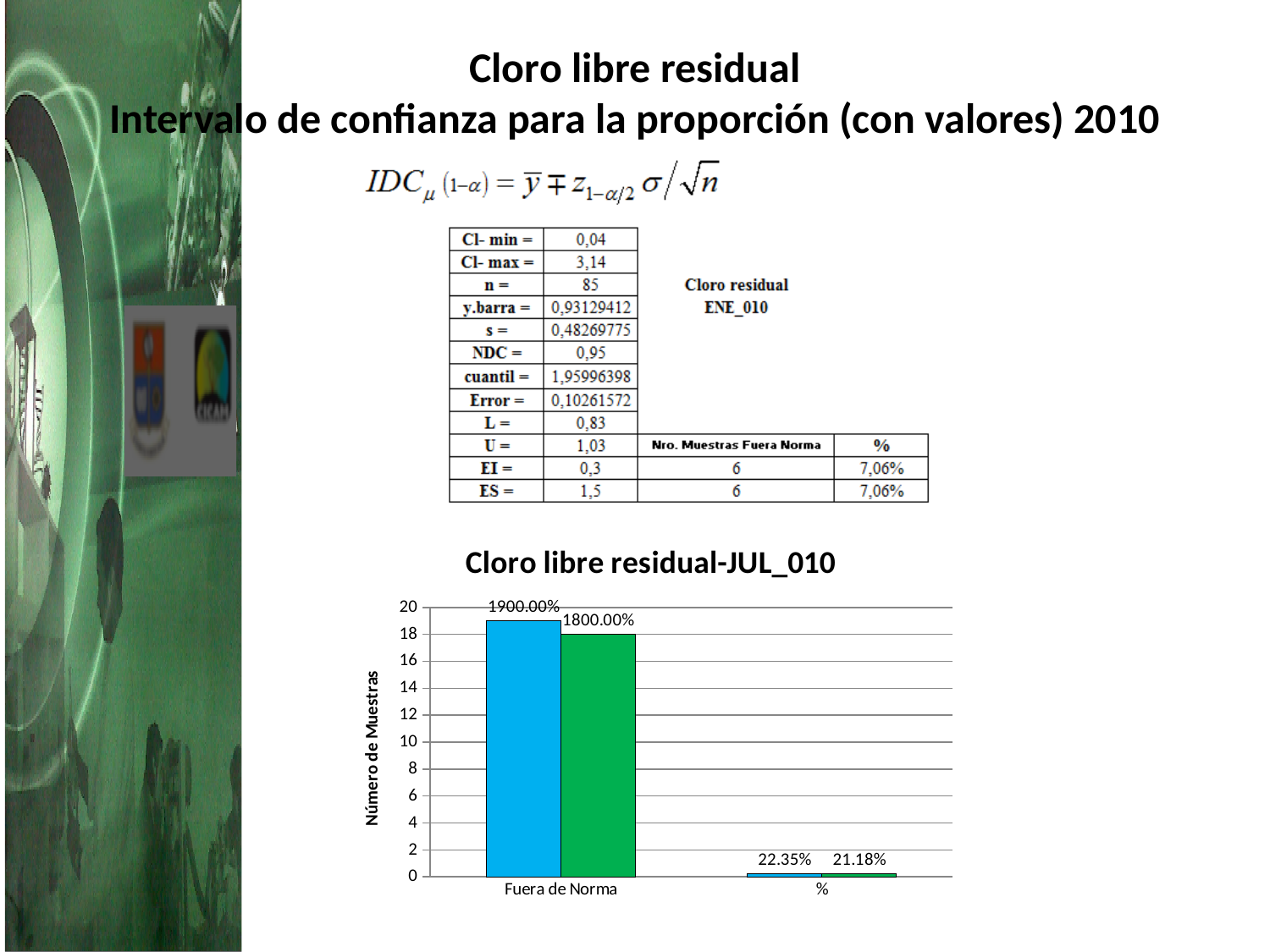
How many categories are shown on the x axis of the chart? 2 What is the data label on the blue bar for Fuera de Norma? 1900.00% What is the data label on the green bar for the % category? 21.18% What is the data label on the blue bar for the % category? 22.35% What is the difference between the blue and green data labels for Fuera de Norma? 100.00% What is the data label on the green bar for Fuera de Norma? 1800.00% Is the blue bar for Fuera de Norma greater or less than 10 on the vertical axis? greater What is the title of the chart on the slide? Cloro libre residual-JUL_010 What kind of chart is shown on the slide? bar chart For Fuera de Norma, which bar is taller, the blue one or the green one? blue What is the label on the vertical axis of the chart? Número de Muestras Which category has the tallest bars in the chart? Fuera de Norma